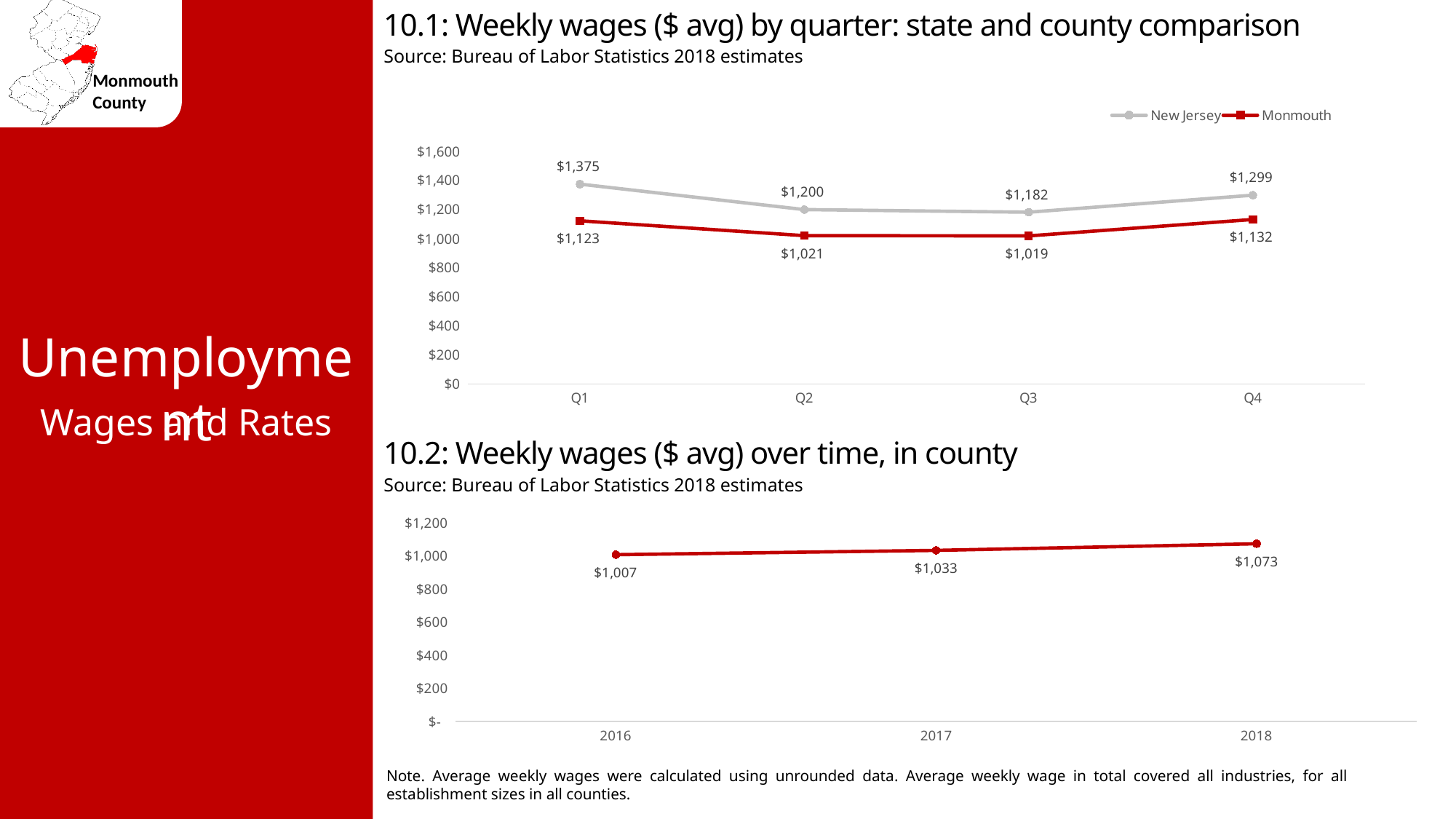
What kind of chart is chart 10.2 (weekly wages over time)? line chart In chart 10.2 (weekly wages over time), how many years are plotted? 3 In chart 10.1 (weekly wages by quarter), which quarter has the highest New Jersey value? Q1 In chart 10.2 (weekly wages over time), do the values rise or fall from 2016 to 2018? rise In chart 10.1 (weekly wages by quarter), how many series does the legend list? 2 In chart 10.1 (weekly wages by quarter), which is larger in Q2: New Jersey or Monmouth? New Jersey In chart 10.1 (weekly wages by quarter), what is the New Jersey value for Q1? $1,375 In chart 10.1 (weekly wages by quarter), which quarter has the lowest Monmouth value? Q3 In chart 10.1 (weekly wages by quarter), what is the Monmouth value for Q3? $1,019 In chart 10.1 (weekly wages by quarter), is the Monmouth value for Q2 greater or less than $1,200? less In chart 10.1 (weekly wages by quarter), what is the difference between the New Jersey and Monmouth values in Q4? $167 In chart 10.2 (weekly wages over time), what is the value for 2017? $1,033